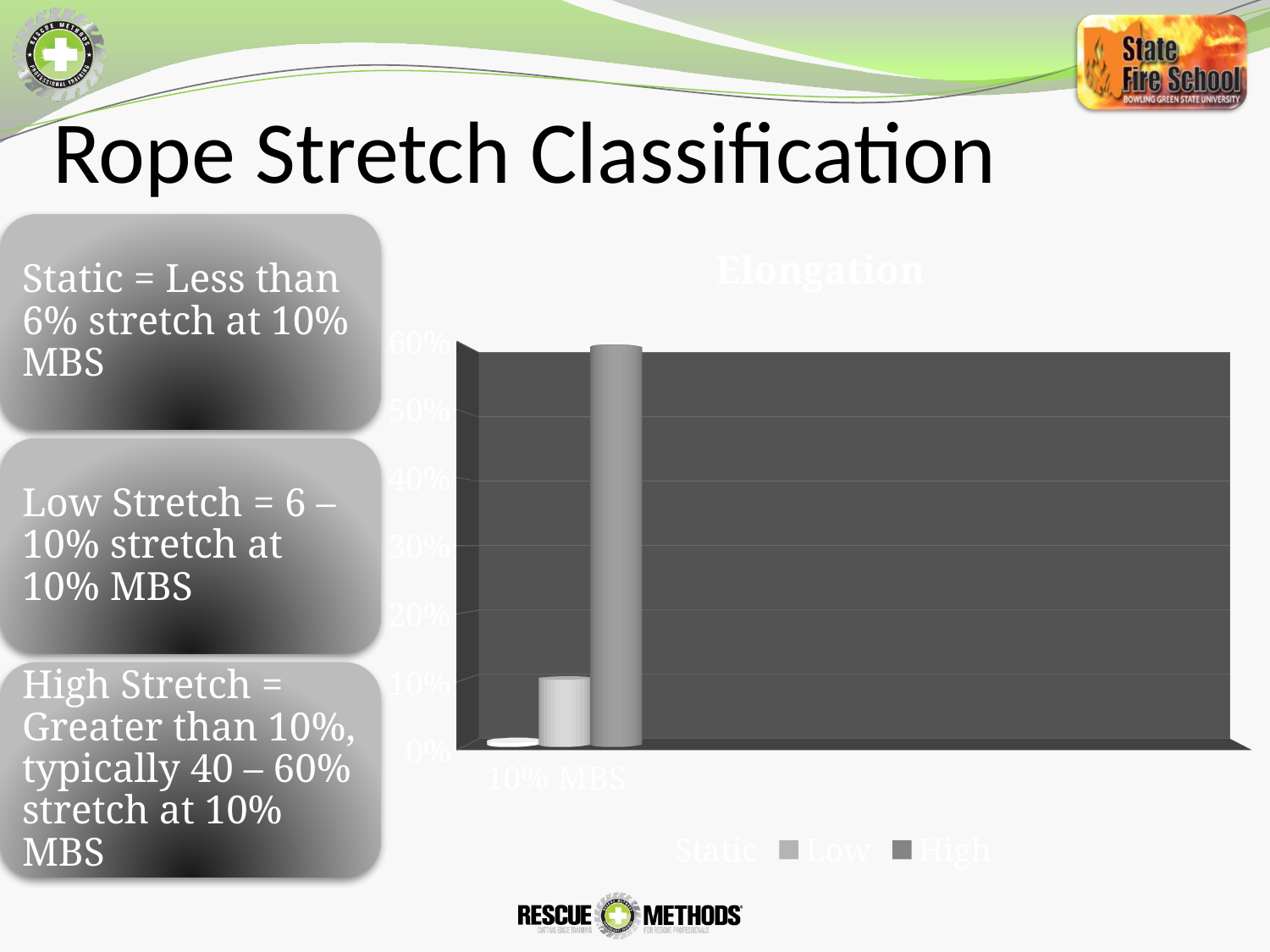
What is the title of the chart? Elongation What kind of chart is shown on the slide? bar chart Is the bar for High greater or less than 50%? greater What is the category label on the x axis of the chart? 10% MBS Which series has the highest bar in the chart? High How many series does the chart legend list? 3 Which series has the lowest bar in the chart? Static How many categories are shown on the x axis of the chart? 1 Which is larger in the chart, the bar for Low or the bar for High? High Is the bar for Static greater or less than 10%? less Is the bar for Low greater or less than 30%? less What are the series names listed in the chart legend? Static, Low, High